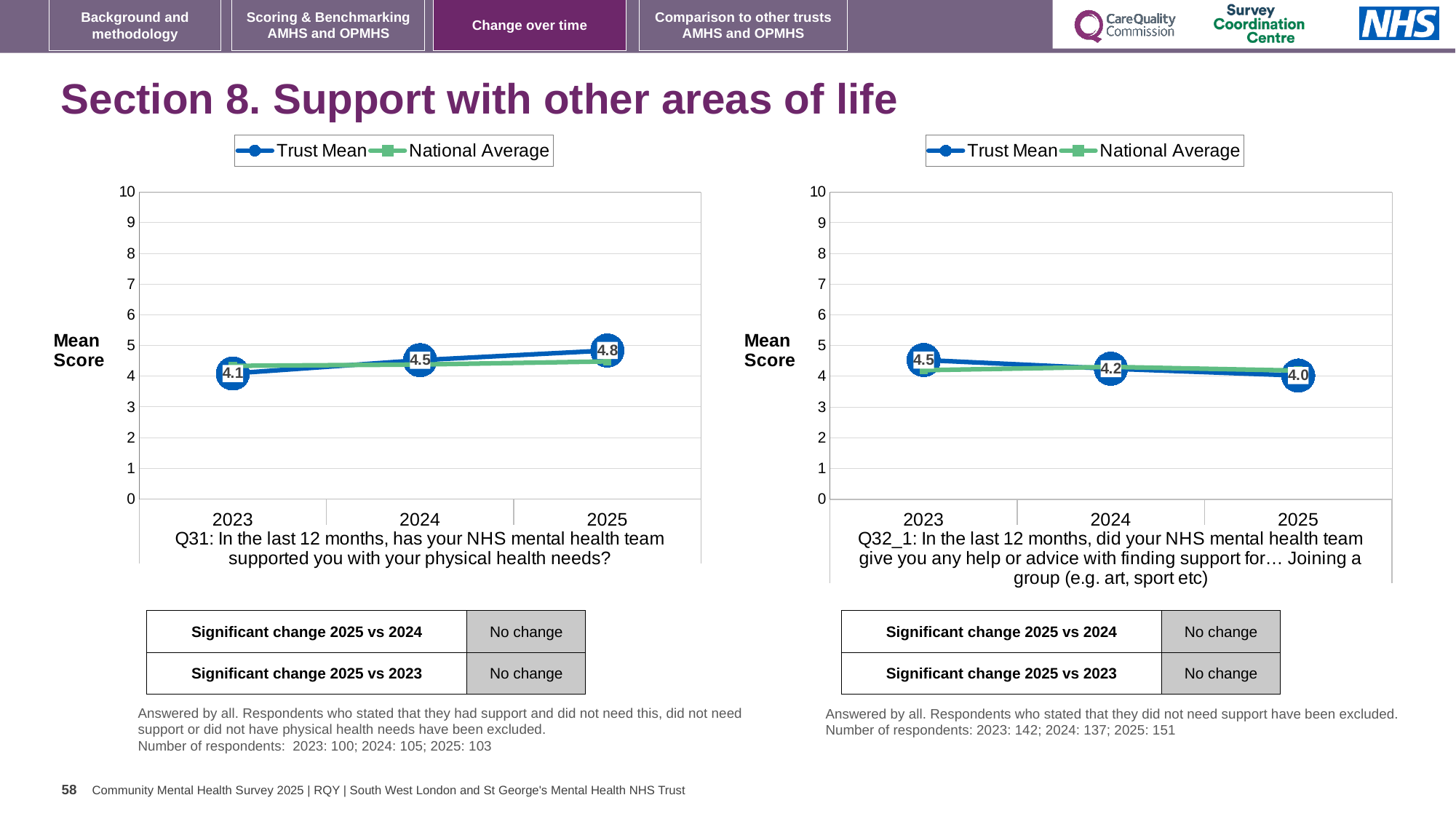
On the right chart (Q32_1), what is the Trust Mean for 2025? 4.0 What kind of chart is the right chart (Q32_1)? line chart On the left chart (Q31), what is the Trust Mean for 2025? 4.8 On the right chart (Q32_1), what is the Trust Mean for 2024? 4.2 On the left chart (Q31), what is the difference between the Trust Mean in 2025 and in 2023? 0.7 On the right chart (Q32_1), what is the difference between the Trust Mean in 2023 and in 2025? 0.5 On the right chart (Q32_1), does the Trust Mean rise or fall from 2023 to 2025? fall On the left chart (Q31), which year has the highest Trust Mean? 2025 On the right chart (Q32_1), which year has the lowest Trust Mean? 2025 How many series does the legend of the left chart (Q31) list? 2 On the left chart (Q31), what is the Trust Mean for 2023? 4.1 On the left chart (Q31), does the Trust Mean rise or fall from 2023 to 2025? rise